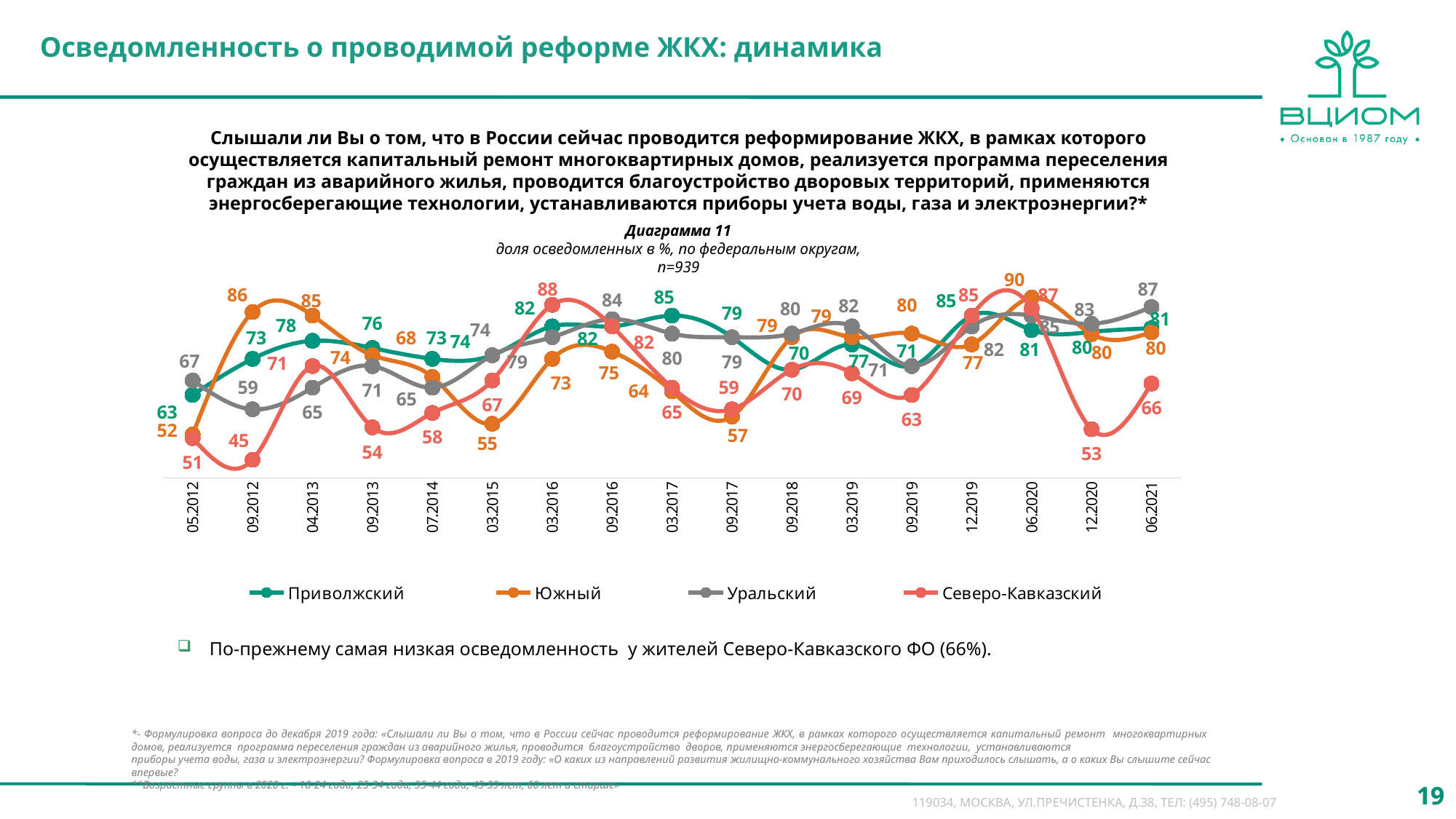
What kind of chart is shown on the slide? line chart What is the value for Уральский in 06.2021? 87 In 12.2020, which is larger: Уральский or Северо-Кавказский? Уральский Which series has the highest value in 06.2021? Уральский How many time points are shown on the x axis? 17 How many series does the legend list? 4 Which series has the lowest value in 06.2021? Северо-Кавказский What is the value for Северо-Кавказский in 06.2021? 66 What is the value for Южный in 05.2012? 52 What is the difference between Уральский and Северо-Кавказский in 06.2021? 21 Does the Северо-Кавказский series rise or fall from 06.2020 to 12.2020? fall What is the value for Северо-Кавказский in 09.2012? 45